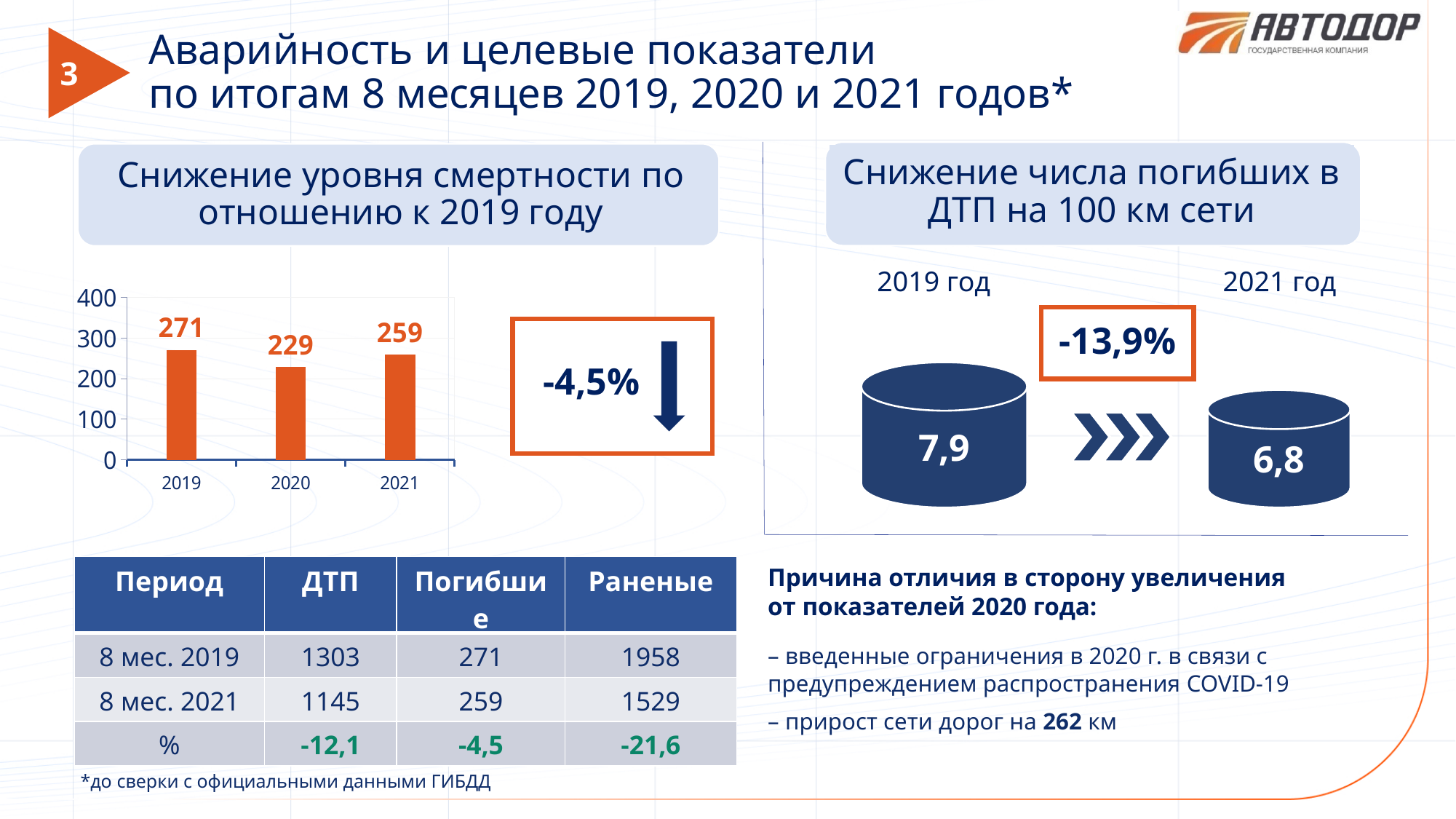
In the bar chart, which year has the highest value? 2019 In the bar chart, what is the value for 2020? 229 What type of chart is shown under the heading "Снижение уровня смертности по отношению к 2019 году"? bar chart In the bar chart, what is the value for 2019? 271 In the bar chart, which is larger: the value for 2020 or the value for 2021? 2021 In the bar chart, is the value for 2020 greater or less than 300? less In the bar chart, what is the difference between the values for 2021 and 2020? 30 What is the highest tick value shown on the vertical axis of the bar chart? 400 How many bars are shown in the bar chart? 3 In the bar chart, what is the value for 2021? 259 In the bar chart, what is the difference between the values for 2019 and 2021? 12 In the bar chart, which year has the lowest value? 2020